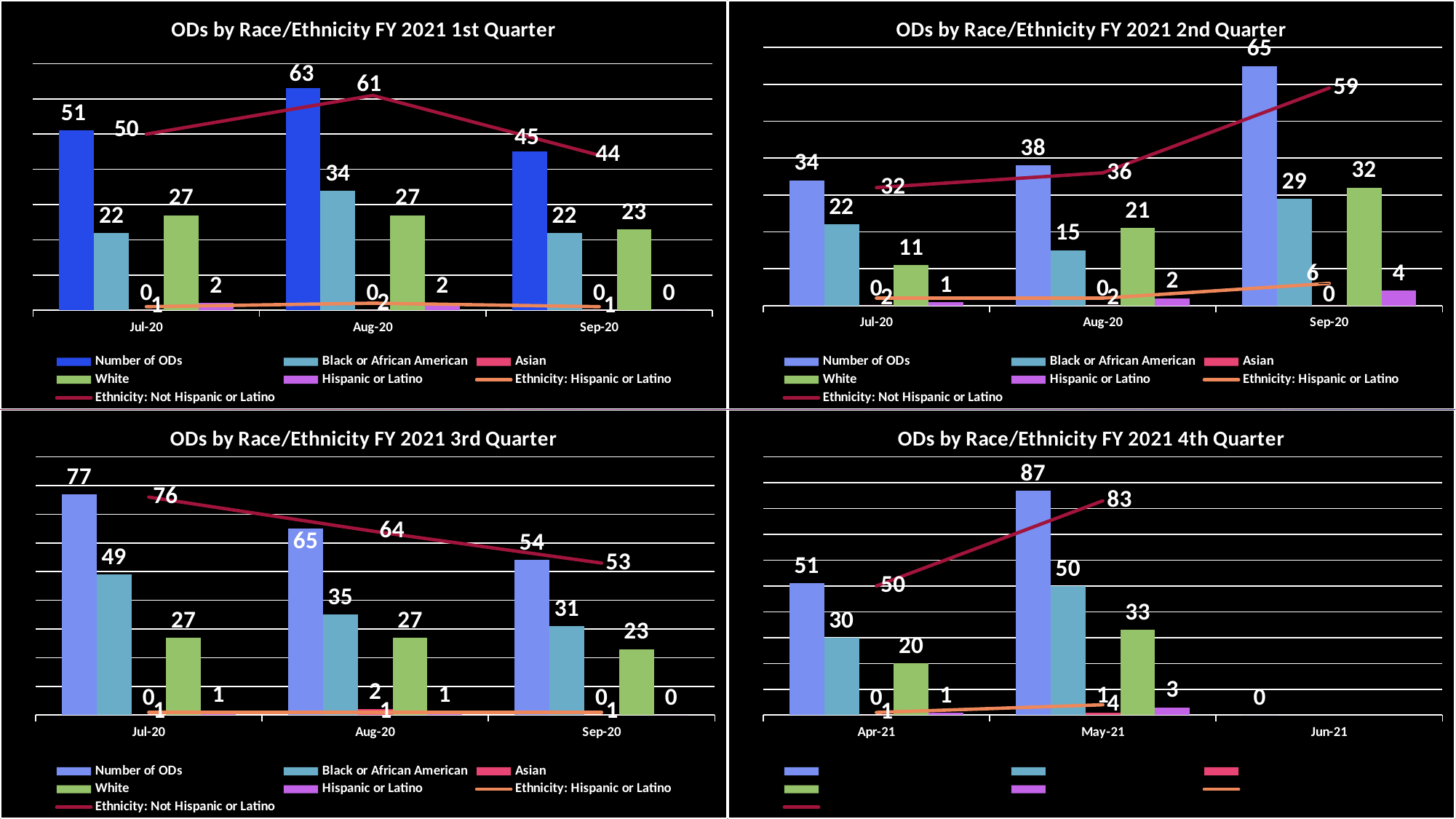
In the 'ODs by Race/Ethnicity FY 2021 1st Quarter' chart, what is the Number of ODs for Aug-20? 63 In the 'ODs by Race/Ethnicity FY 2021 4th Quarter' chart, what is the Number of ODs for May-21? 87 In the 'ODs by Race/Ethnicity FY 2021 3rd Quarter' chart, which month has the lowest Ethnicity: Not Hispanic or Latino value? Sep-20 In the 'ODs by Race/Ethnicity FY 2021 2nd Quarter' chart, does the Ethnicity: Not Hispanic or Latino line rise or fall from Jul-20 to Sep-20? rise How many months are shown on the x axis of the 'ODs by Race/Ethnicity FY 2021 4th Quarter' chart? 3 In the 'ODs by Race/Ethnicity FY 2021 3rd Quarter' chart, does the Number of ODs rise or fall from Jul-20 to Sep-20? fall In the 'ODs by Race/Ethnicity FY 2021 1st Quarter' chart, which month has the highest Number of ODs? Aug-20 In the 'ODs by Race/Ethnicity FY 2021 2nd Quarter' chart, what is the difference between the Number of ODs for Sep-20 and Jul-20? 31 In the 'ODs by Race/Ethnicity FY 2021 3rd Quarter' chart, what is the Black or African American value for Jul-20? 49 How many series does the legend of the 'ODs by Race/Ethnicity FY 2021 1st Quarter' chart list? 7 In the 'ODs by Race/Ethnicity FY 2021 4th Quarter' chart, which is larger: the Number of ODs for Apr-21 or for May-21? May-21 In the 'ODs by Race/Ethnicity FY 2021 2nd Quarter' chart, what is the White value for Sep-20? 32